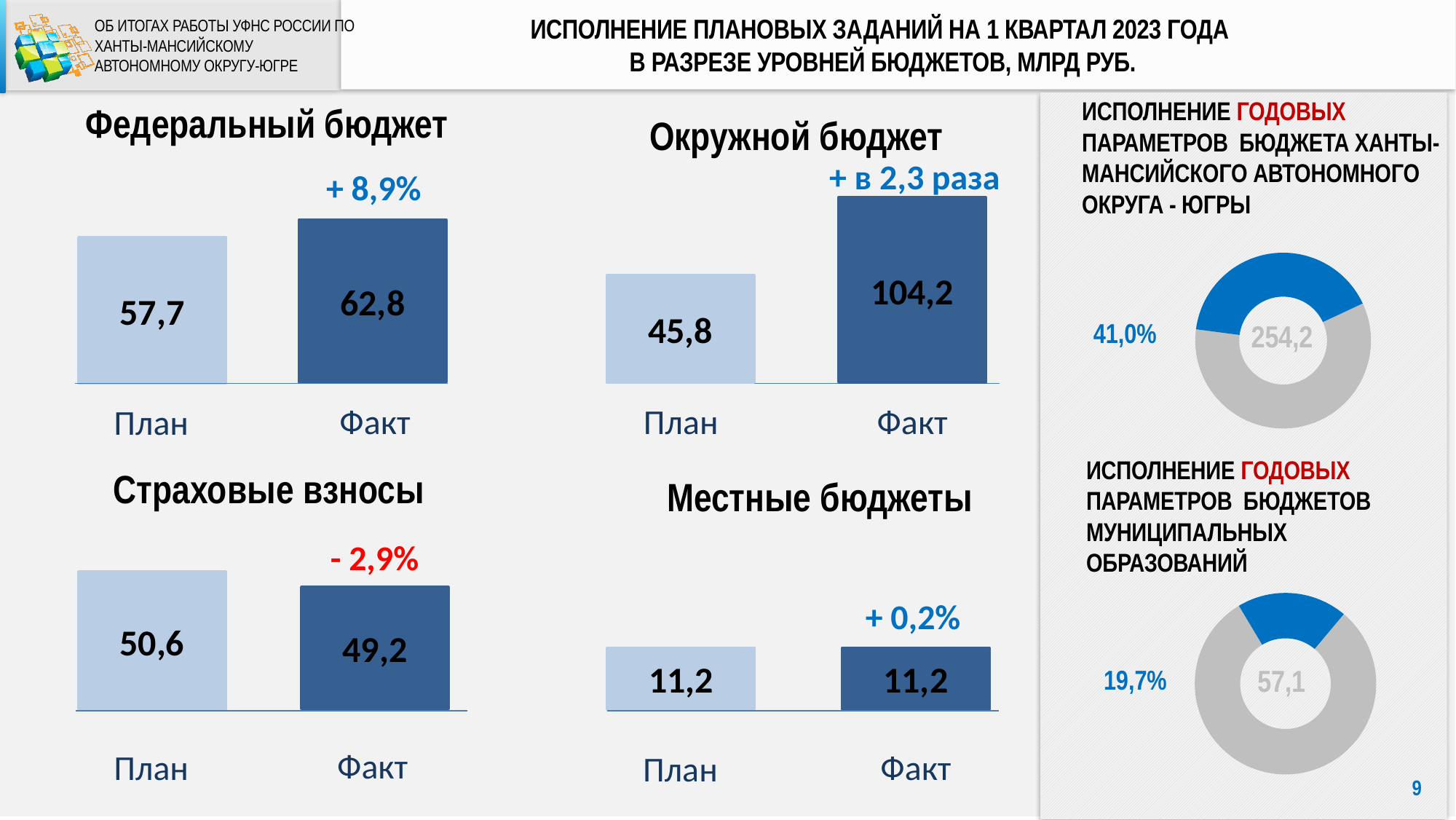
What kind of chart is used for 'Окружной бюджет'? Bar chart In the 'Страховые взносы' chart, what is the value for Факт? 49,2 In the lower donut chart on the right (бюджетов муниципальных образований), what value is shown in the centre? 57,1 How many bars are in the 'Местные бюджеты' chart? 2 In the upper donut chart on the right (Ханты-Мансийского автономного округа - Югры), what percentage is shown? 41,0% In the 'Окружной бюджет' chart, what is the difference between Факт and План? 58,4 In the 'Страховые взносы' chart, which is larger, План or Факт? План In the 'Федеральный бюджет' chart, what is the value for Факт? 62,8 In the 'Окружной бюджет' chart, what is the value for Факт? 104,2 In the 'Федеральный бюджет' chart, what is the difference between Факт and План? 5,1 In the 'Федеральный бюджет' chart, what is the value for План? 57,7 In the 'Местные бюджеты' chart, what is the value for План? 11,2